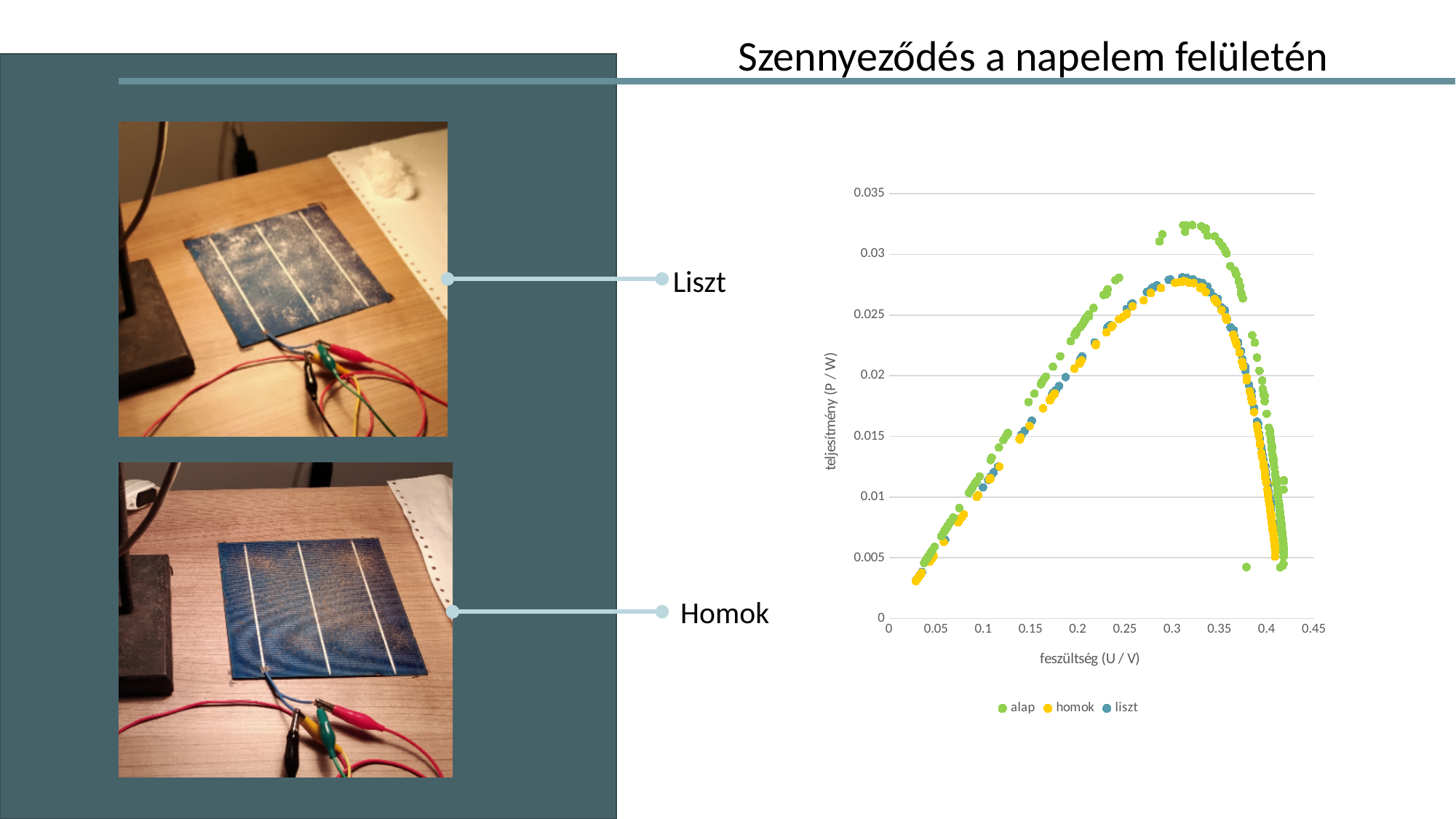
Is the peak value of the alap series greater or less than 0.03? greater What is the label of the chart's x axis? feszültség (U / V) Is the peak value of the liszt series greater or less than 0.025? greater How many series does the chart legend list? 3 Is the peak value of the homok series greater or less than 0.03? less What kind of chart is shown on the slide? scatter chart Which series has the larger peak power: alap or homok? alap How do the power values change as voltage increases from 0 to about 0.3 V? they rise Which series reaches the highest power (teljesítmény) value in the chart? alap How do the power values change as voltage increases beyond about 0.35 V? they fall Which series are listed in the chart legend? alap, homok, liszt